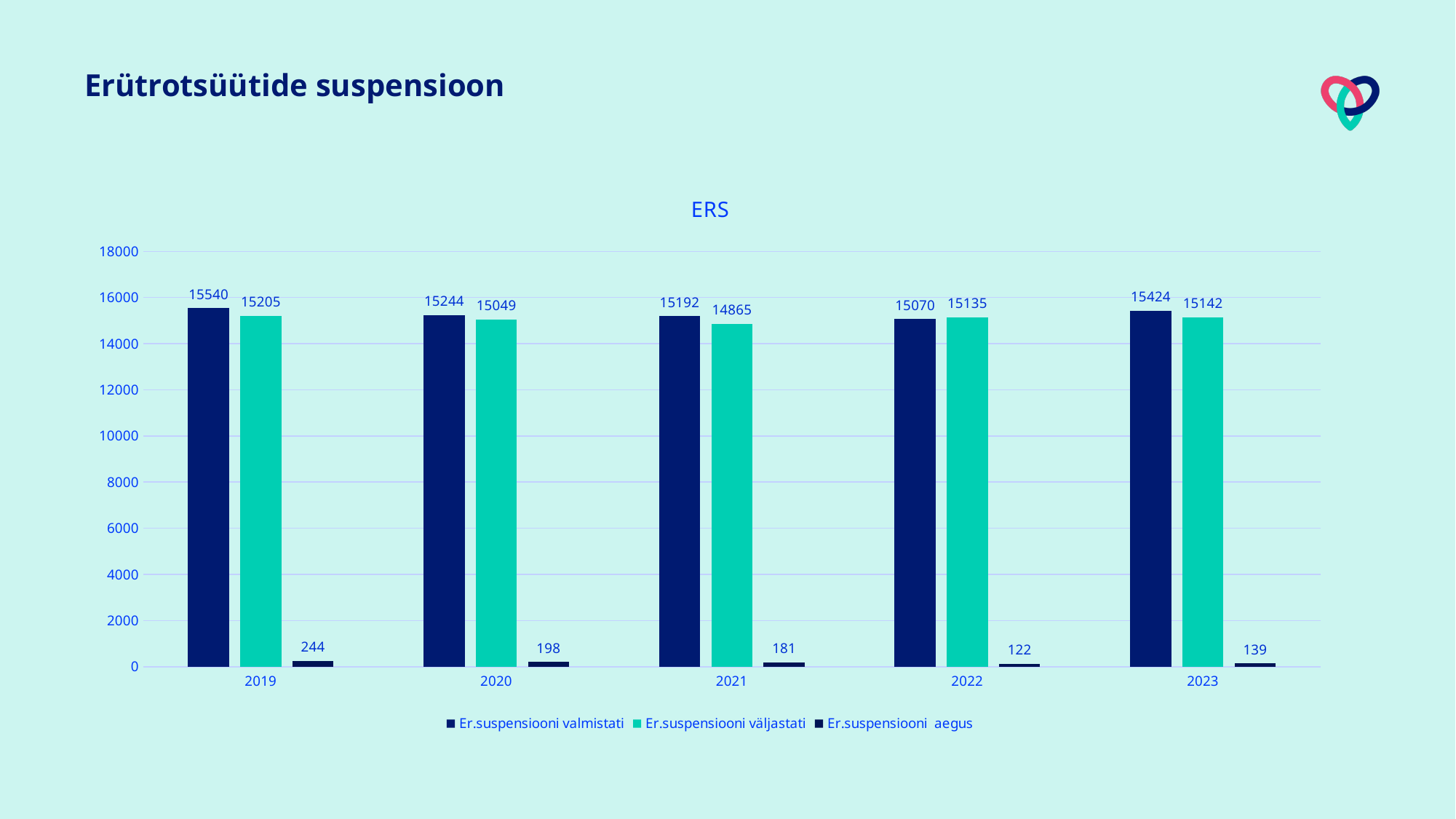
How many series does the legend list? 3 What is the value of Er.suspensiooni aegus for 2022? 122 What is the value of Er.suspensiooni väljastati for 2021? 14865 In which year is Er.suspensiooni aegus lowest? 2022 What is the difference between Er.suspensiooni valmistati and Er.suspensiooni väljastati in 2020? 195 What is the title of the chart? ERS What is the value of Er.suspensiooni valmistati for 2019? 15540 Is the value of Er.suspensiooni väljastati for 2023 greater or less than 14000? greater What kind of chart is shown? bar chart Which is larger in 2022: Er.suspensiooni valmistati or Er.suspensiooni väljastati? Er.suspensiooni väljastati In which year is Er.suspensiooni valmistati highest? 2019 How many years are shown on the x axis? 5